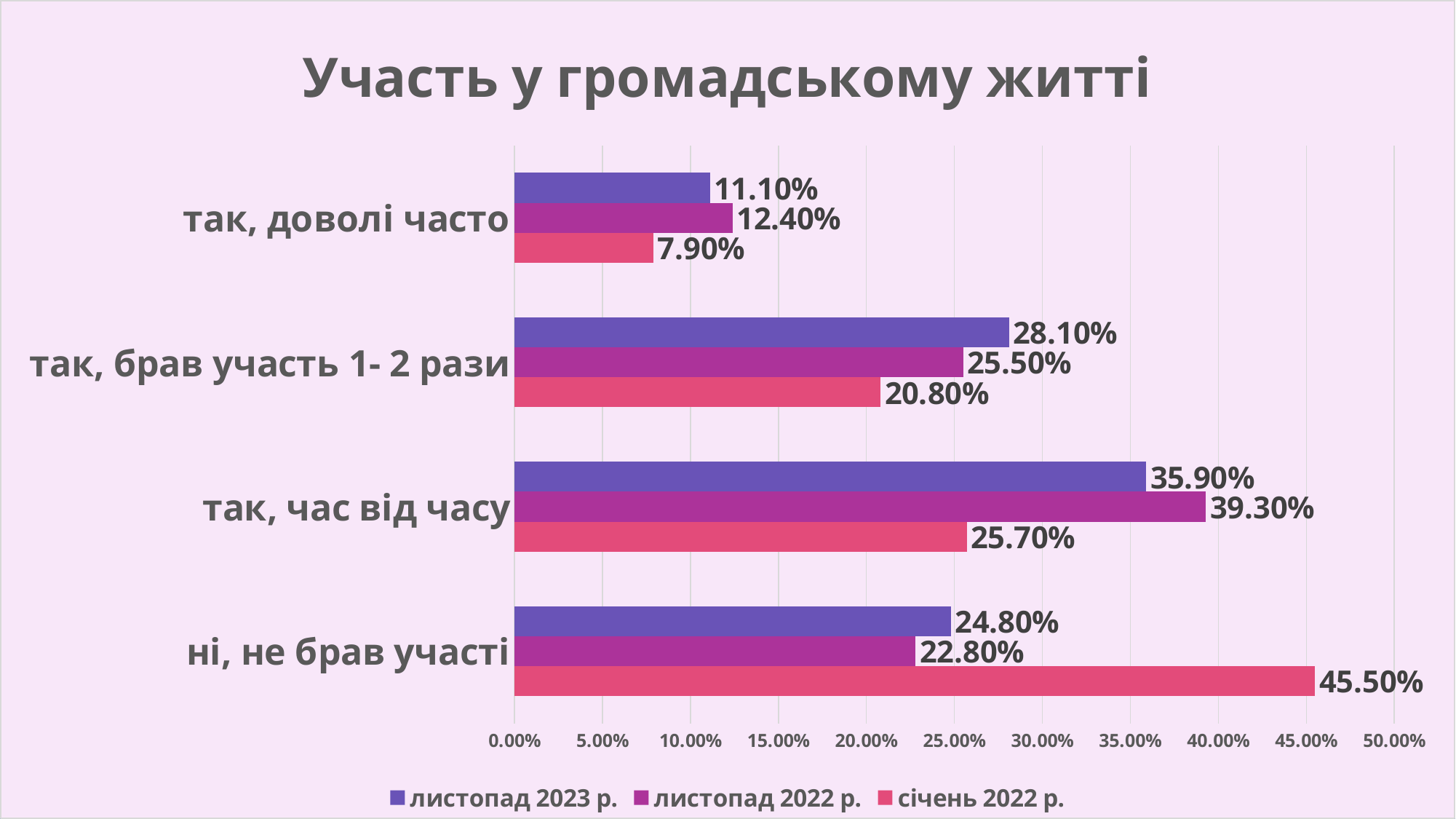
What is the value for "так, доволі часто" in the "листопад 2023 р." series? 11.10% Which category has the lowest value in the "листопад 2023 р." series? так, доволі часто Is the value for "так, час від часу" in the "листопад 2022 р." series greater or less than 35.00%? greater What is the difference between the "січень 2022 р." and "листопад 2022 р." values for "ні, не брав участі"? 22.70% What is the value for "ні, не брав участі" in the "січень 2022 р." series? 45.50% What is the value for "так, час від часу" in the "листопад 2022 р." series? 39.30% What kind of chart is shown on the slide? bar chart For "так, брав участь 1- 2 рази", which series has the larger value: "листопад 2023 р." or "січень 2022 р."? листопад 2023 р. What is the title of the chart? Участь у громадському житті How many series does the legend list? 3 How many categories are shown on the chart? 4 Which category has the highest value in the "січень 2022 р." series? ні, не брав участі